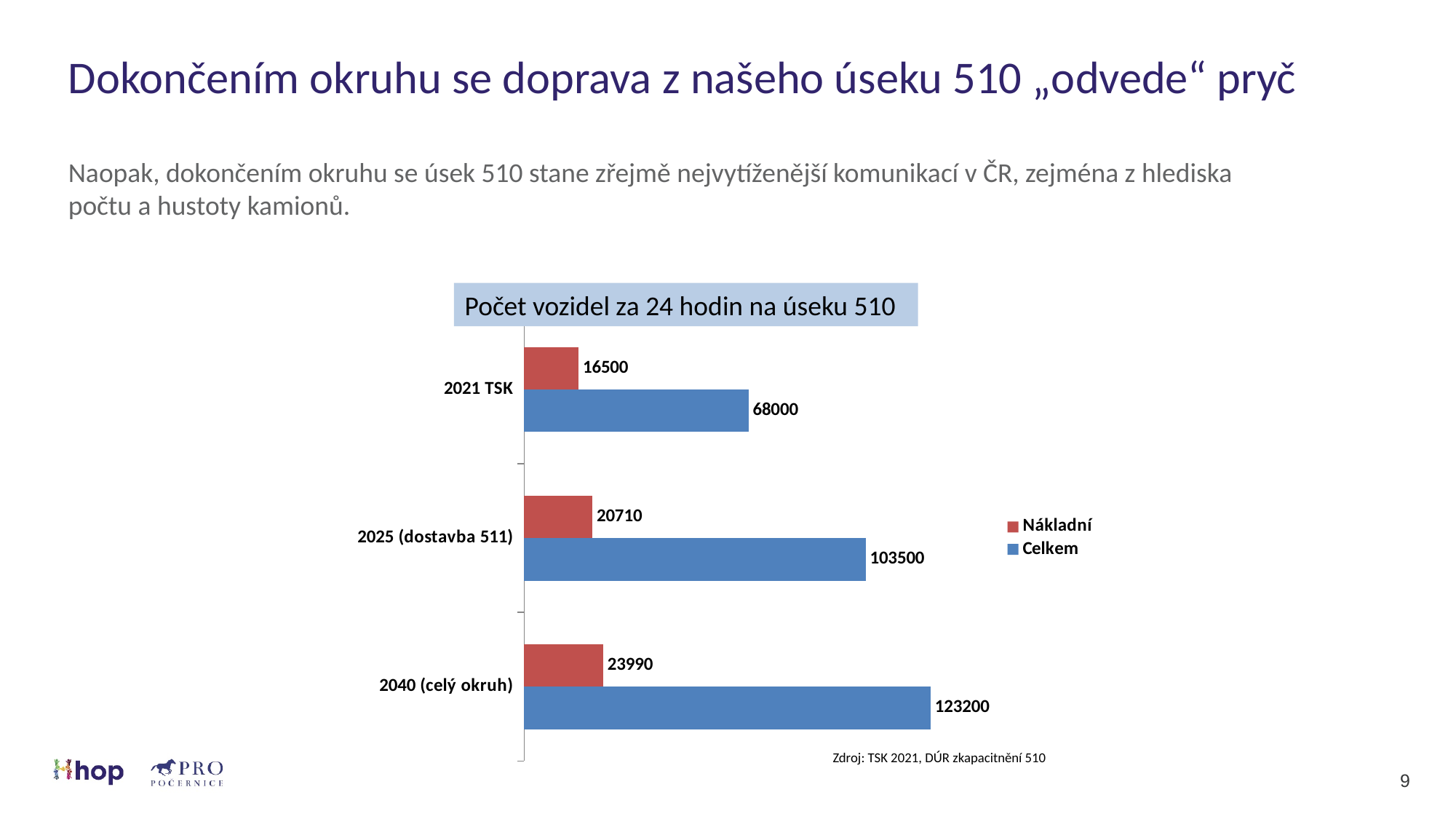
Which category has the highest Celkem value? 2040 (celý okruh) What is the Celkem value for 2040 (celý okruh)? 123200 What is the Nákladní value for 2021 TSK? 16500 How many categories are shown on the chart? 3 What is the difference between the Celkem values for 2040 (celý okruh) and 2021 TSK? 55200 What is the Celkem value for 2021 TSK? 68000 What is the difference between the Nákladní values for 2040 (celý okruh) and 2025 (dostavba 511)? 3280 Which is larger: the Celkem value for 2025 (dostavba 511) or the Celkem value for 2021 TSK? 2025 (dostavba 511) What is the Nákladní value for 2025 (dostavba 511)? 20710 What kind of chart is shown on the slide? Bar chart Which category has the lowest Nákladní value? 2021 TSK How many series does the legend list? 2